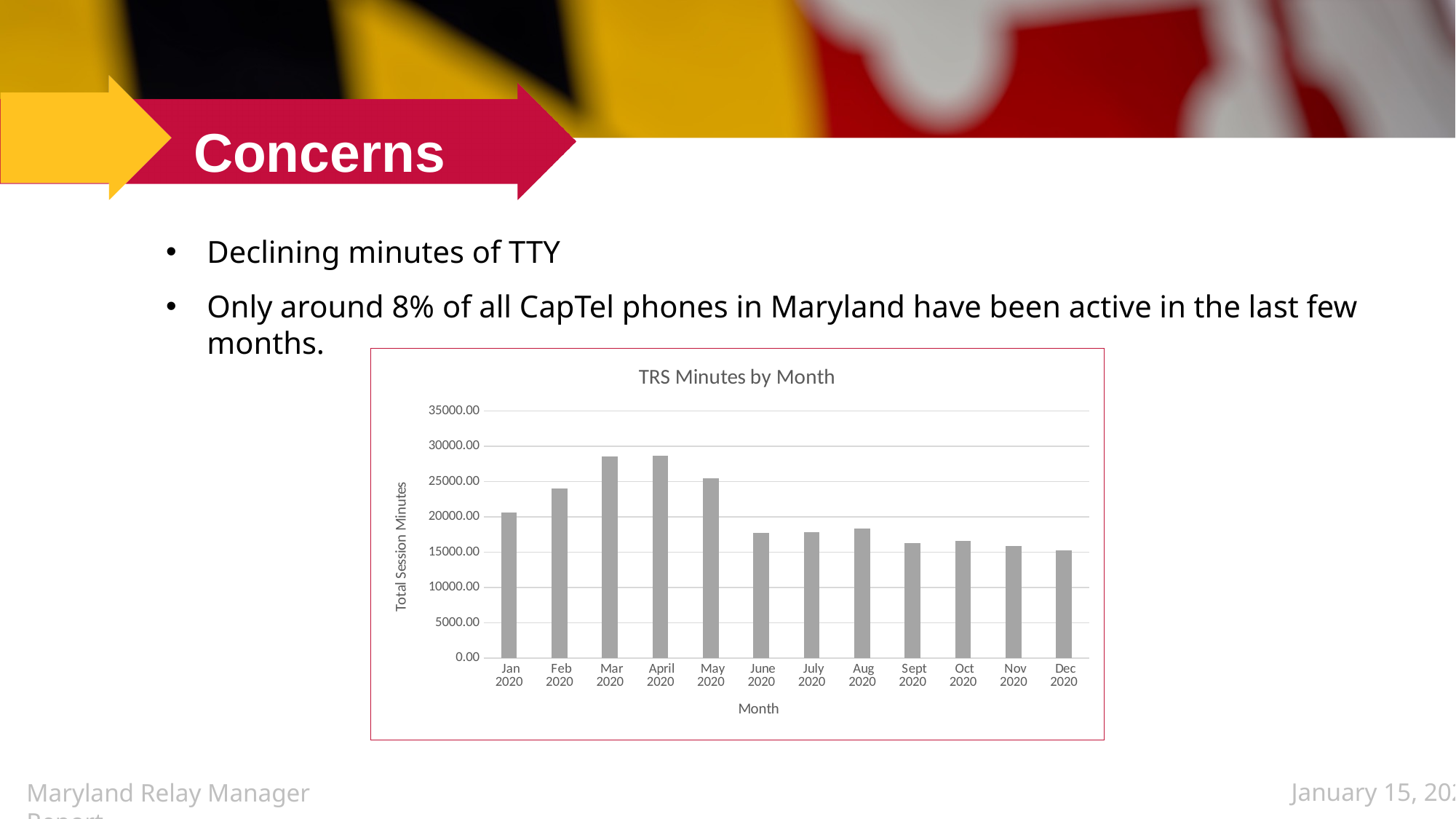
What type of chart is shown on the slide? Bar chart Is the value for Feb 2020 greater or less than 25000.00? less Which month has the larger value, Feb 2020 or June 2020? Feb 2020 Do the values generally rise or fall from May 2020 to Dec 2020? Fall How many months are plotted in the chart? 12 What is the title of the chart? TRS Minutes by Month Is the value for Aug 2020 greater or less than 20000.00? less Which month has the larger value, Mar 2020 or Jan 2020? Mar 2020 What is the label on the vertical axis of the chart? Total Session Minutes Is the value for Mar 2020 greater or less than 25000.00? greater Which month has the larger value, Aug 2020 or Sept 2020? Aug 2020